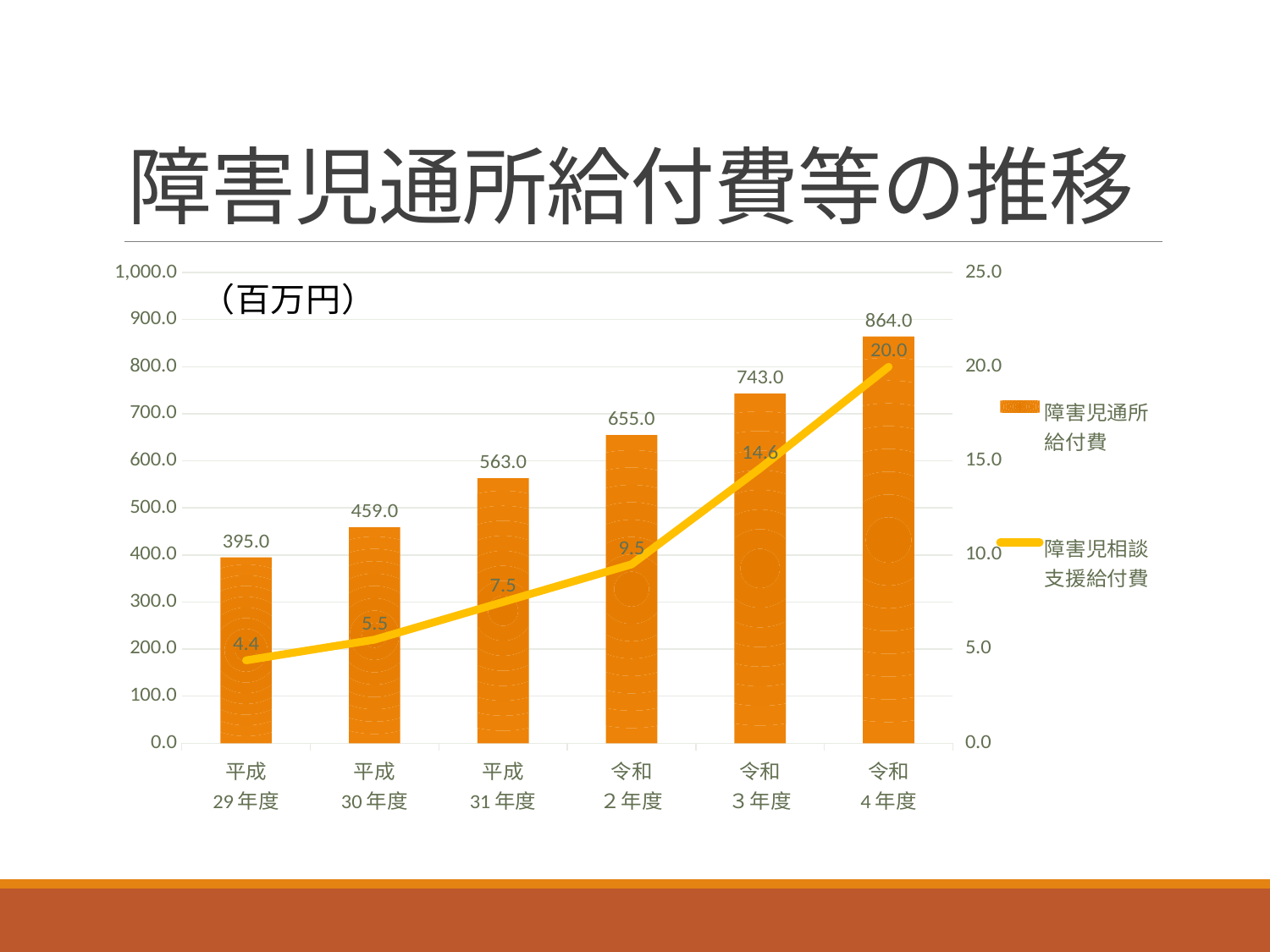
What is the value of 障害児相談支援給付費 for 平成29年度? 4.4 How many series does the legend list? 2 What kind of chart is this? Combined bar and line chart What is the difference in 障害児通所給付費 between 令和4年度 and 平成29年度? 469.0 Which is larger, 障害児通所給付費 for 令和2年度 or for 平成30年度? 令和2年度 What is the value of 障害児通所給付費 for 令和4年度? 864.0 What is the value of 障害児相談支援給付費 for 令和3年度? 14.6 How many years are shown on the x axis? 6 Which year has the highest 障害児通所給付費? 令和4年度 Which year has the lowest 障害児相談支援給付費? 平成29年度 What is the value of 障害児通所給付費 for 平成31年度? 563.0 Do the 障害児相談支援給付費 values rise or fall from 平成29年度 to 令和4年度? Rise